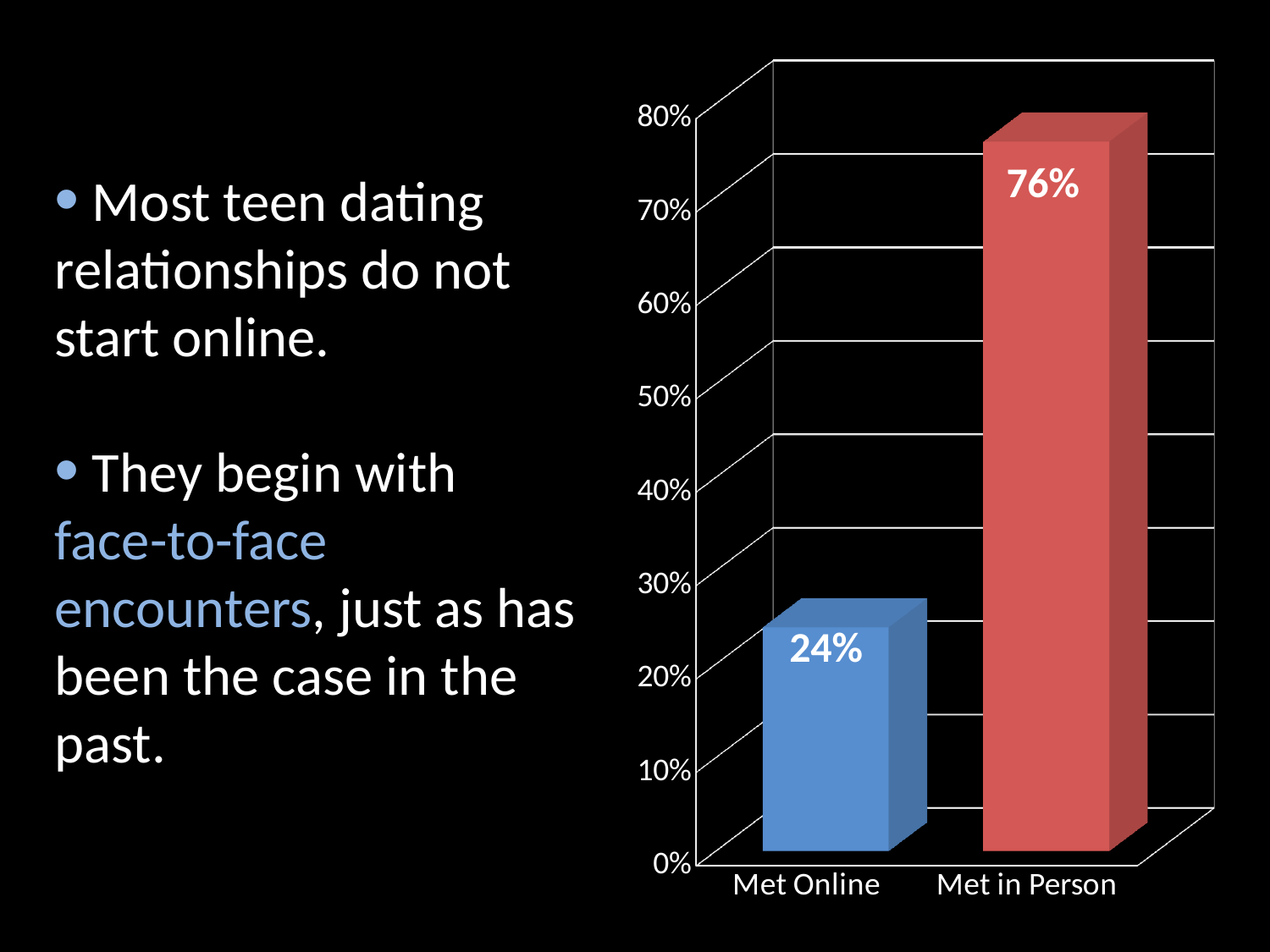
Is the value for Met Online greater or less than 30%? less What is the difference between the values for Met in Person and Met Online? 52% What kind of chart is shown on the slide? bar chart Which category has the lowest value? Met Online What is the value for Met Online? 24% Which is larger, the value for Met Online or the value for Met in Person? Met in Person Is the value for Met in Person greater or less than 70%? greater What is the value for Met in Person? 76% What colour is the bar for Met in Person? red How many categories are shown on the chart? 2 What colour is the bar for Met Online? blue Which category has the highest value? Met in Person